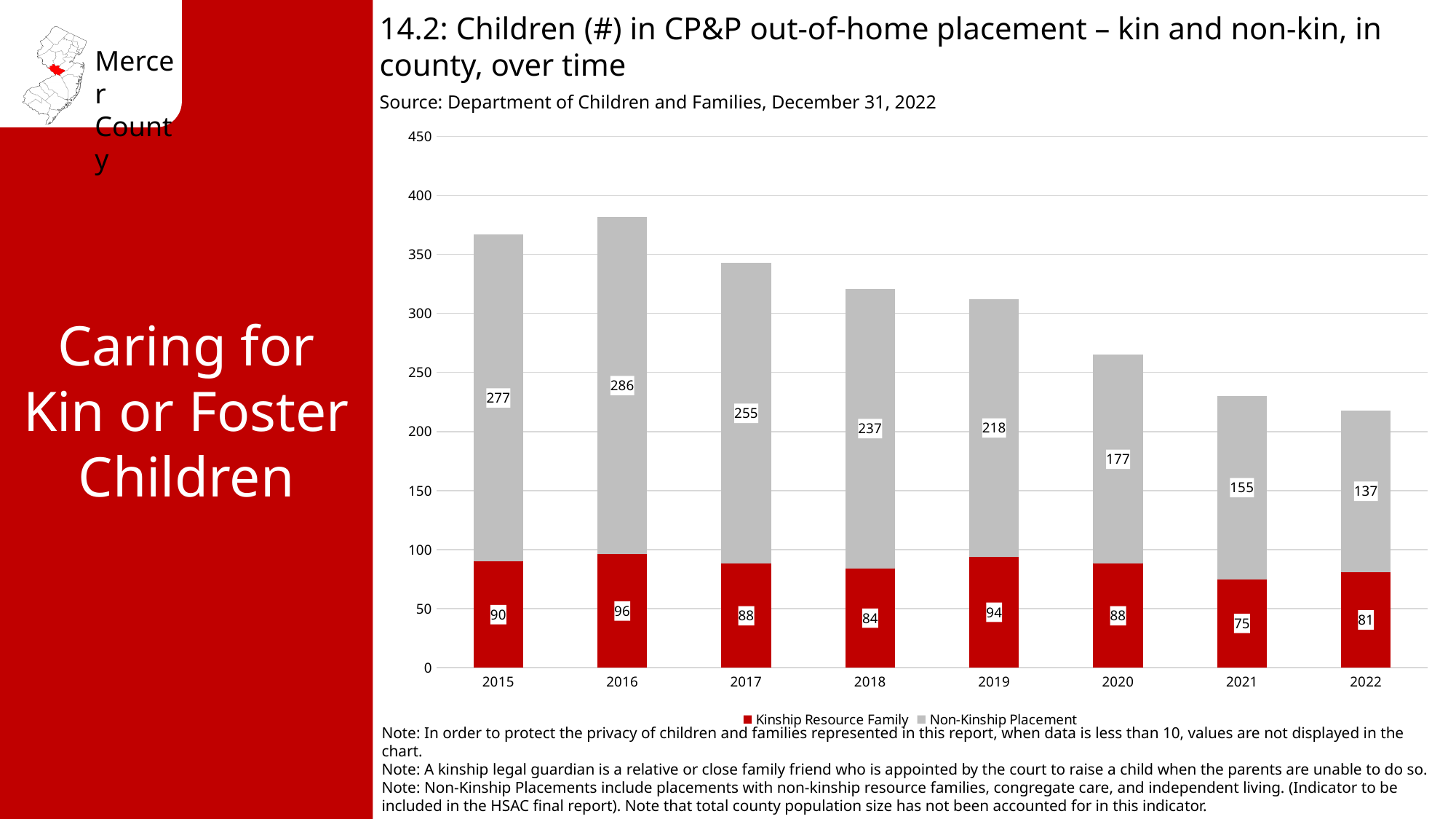
What is the Kinship Resource Family value for 2021? 75 What is the total of the stacked bar for 2022? 218 What is the difference between the Non-Kinship Placement values for 2015 and 2022? 140 Do the Non-Kinship Placement values rise or fall from 2016 to 2022? Fall Which is larger, the Kinship Resource Family value for 2019 or for 2020? 2019 How many series does the legend list? 2 Is the total of the stacked bar for 2016 greater or less than 350? greater How many years are shown on the x axis? 8 Which year has the lowest Kinship Resource Family value? 2021 What kind of chart is shown on the slide? Stacked bar chart Which year has the highest Non-Kinship Placement value? 2016 What is the Non-Kinship Placement value for 2016? 286